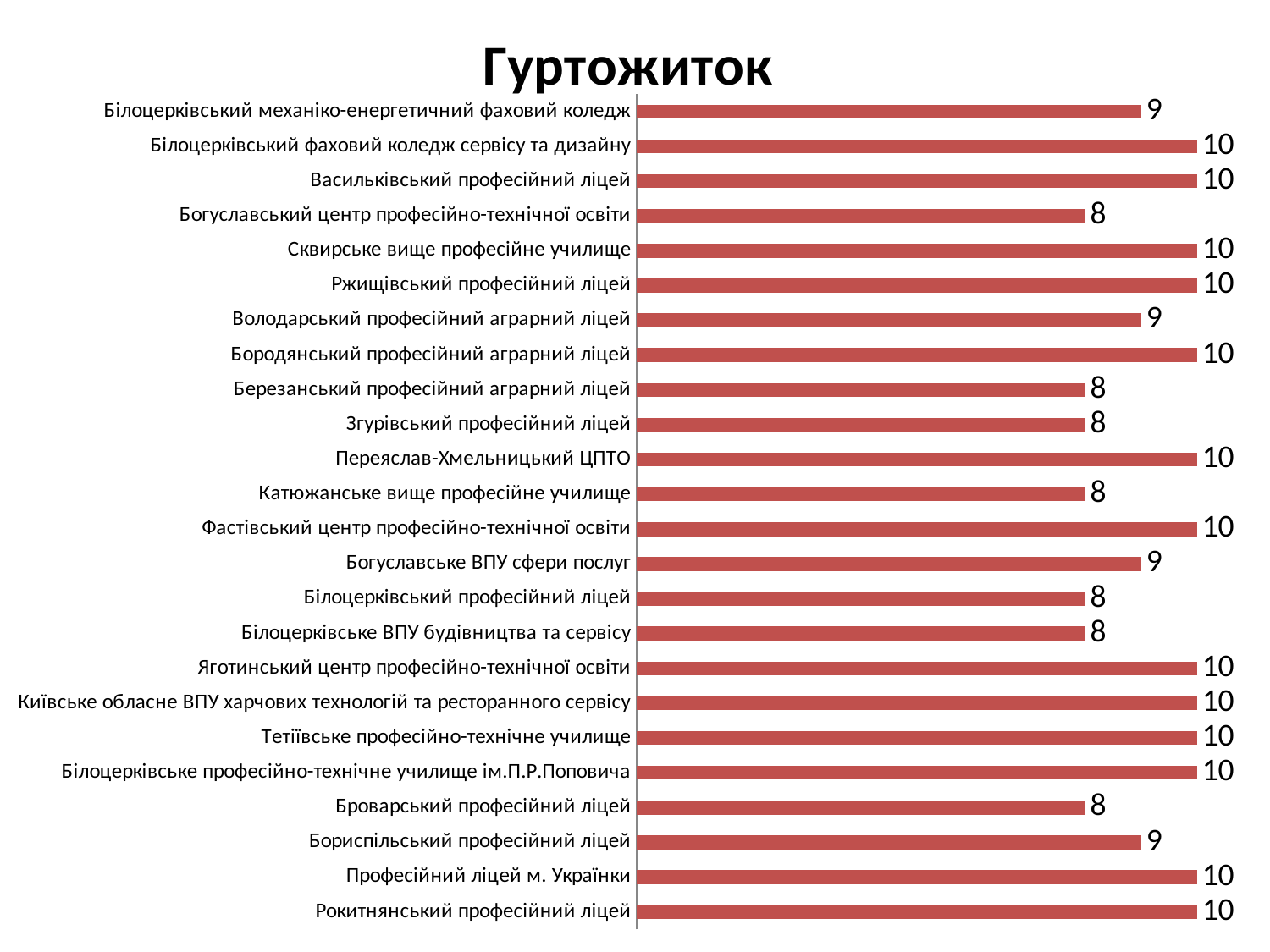
What is the value for Володарський професійний аграрний ліцей? 9 What is the title of the chart? Гуртожиток What is the value for Переяслав-Хмельницький ЦПТО? 10 What kind of chart is shown on the slide? Bar chart What is the value for Богуславський центр професійно-технічної освіти? 8 What is the difference between the values for Васильківський професійний ліцей and Згурівський професійний ліцей? 2 What is the value for Броварський професійний ліцей? 8 What is the value for Рокитнянський професійний ліцей? 10 How many categories are shown in the chart? 24 What is the value for Бориспільський професійний ліцей? 9 What is the difference between the values for Богуславське ВПУ сфери послуг and Катюжанське вище професійне училище? 1 Which has a larger value, Сквирське вище професійне училище or Білоцерківський професійний ліцей? Сквирське вище професійне училище